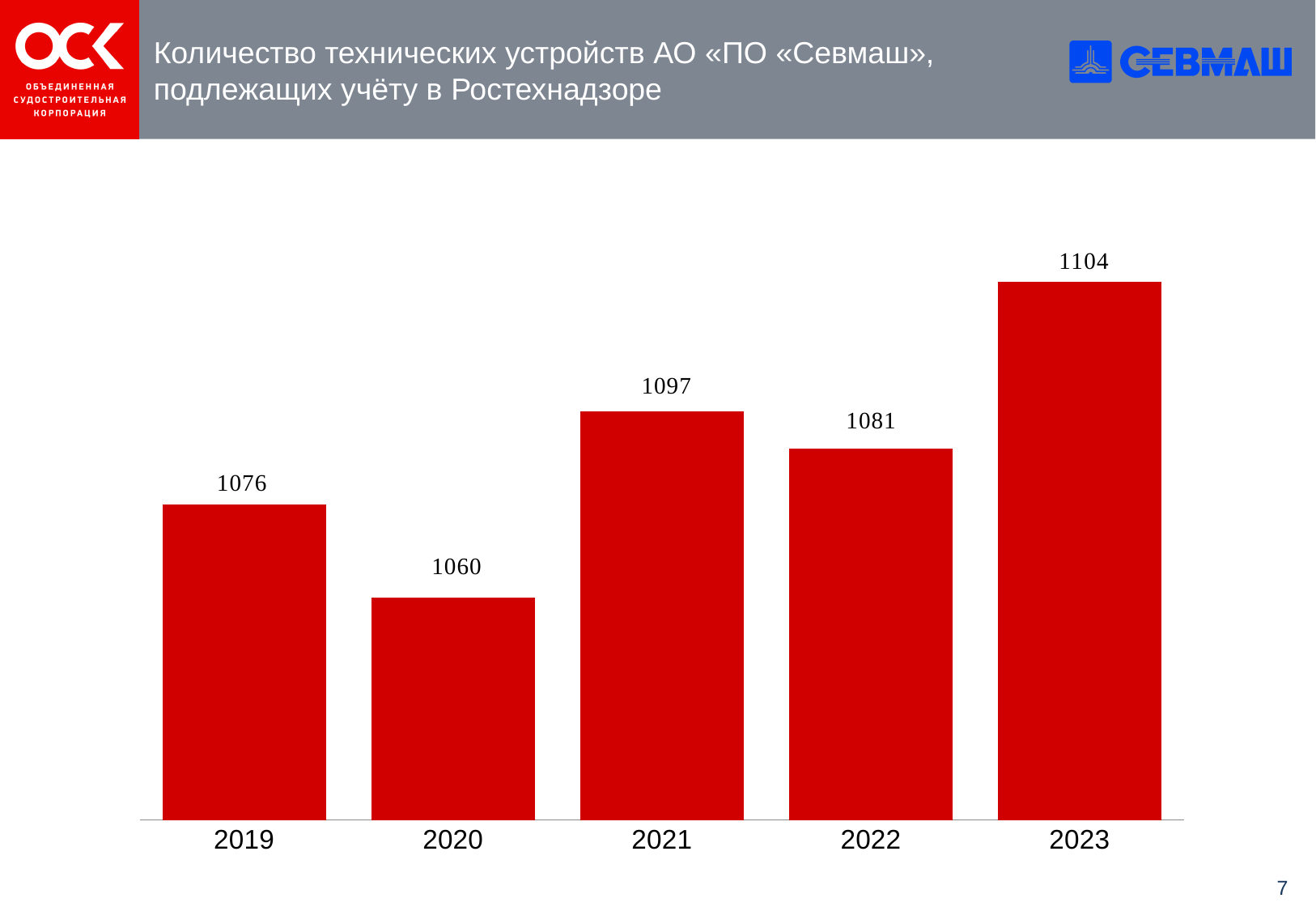
What is the value for 2020? 1060 What is the value for 2022? 1081 Which year has the lowest value? 2020 Which is larger, the value for 2021 or the value for 2022? 2021 How many years are shown on the x axis? 5 What is the difference between the values for 2023 and 2019? 28 What colour are the bars in the chart? Red What is the value for 2023? 1104 What is the value for 2021? 1097 What is the value for 2019? 1076 What kind of chart is shown on the slide? Bar chart Which year has the highest value? 2023